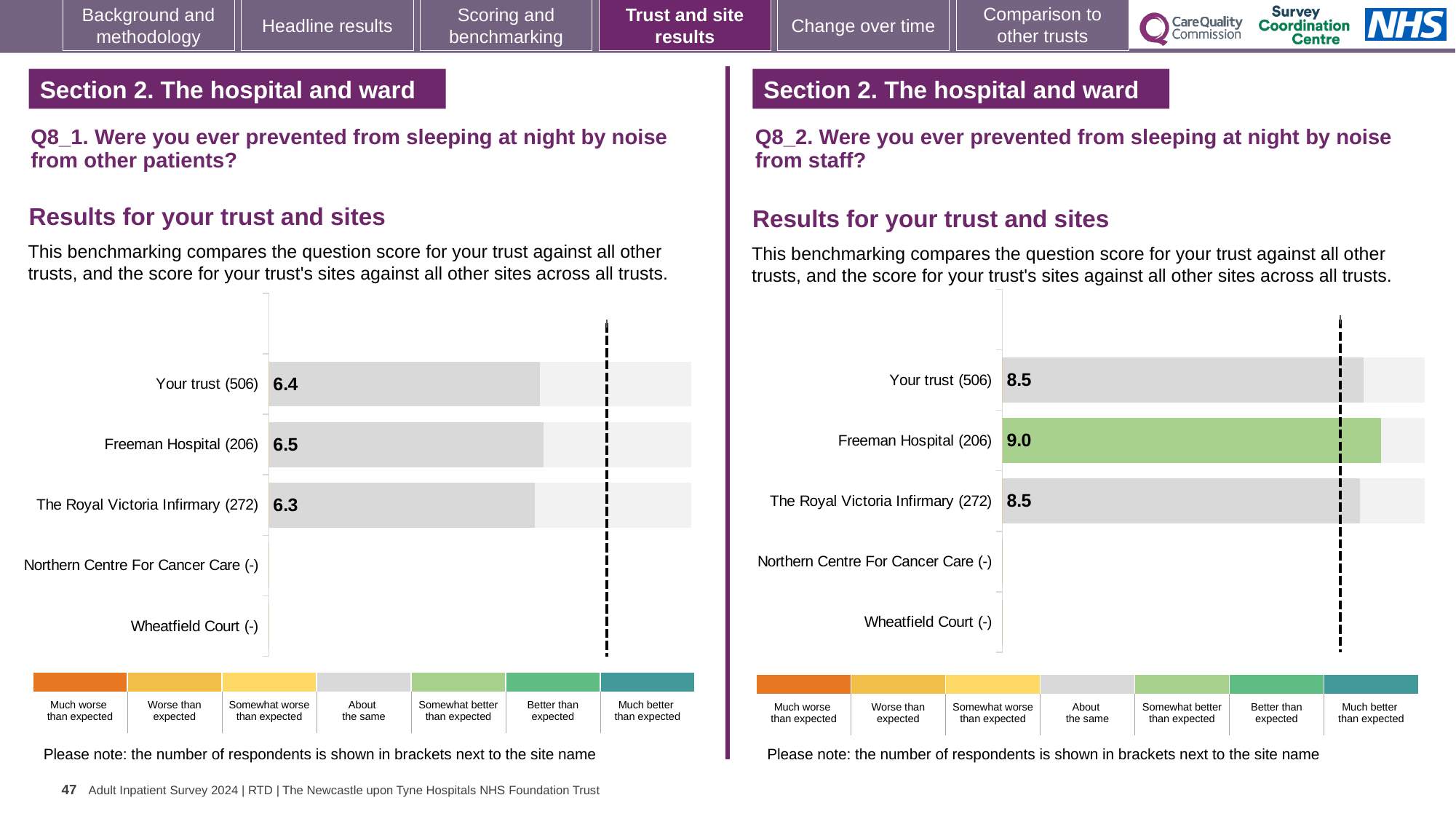
On the Q8_2 chart (noise from staff), what is the score for Freeman Hospital? 9.0 On the Q8_1 chart (noise from other patients), what is the difference between the Freeman Hospital score and The Royal Victoria Infirmary score? 0.2 On the Q8_2 chart (noise from staff), what is the difference between the Freeman Hospital score and the Your trust score? 0.5 On the Q8_2 chart (noise from staff), which is larger: the score for Freeman Hospital or the score for Your trust? Freeman Hospital What kind of chart is used on the Q8_2 chart (noise from staff)? Bar chart On the Q8_2 chart (noise from staff), which site or trust has the highest score? Freeman Hospital On the Q8_1 chart (noise from other patients), which site or trust has the highest score? Freeman Hospital On the Q8_1 chart (noise from other patients), what is the score for The Royal Victoria Infirmary? 6.3 On the Q8_1 chart (noise from other patients), what is the score for Freeman Hospital? 6.5 On the Q8_2 chart (noise from staff), what is the score for The Royal Victoria Infirmary? 8.5 How many sites or trusts are listed on the Q8_1 chart (noise from other patients), including those with no score? 5 On the Q8_1 chart (noise from other patients), what is the score for Your trust? 6.4